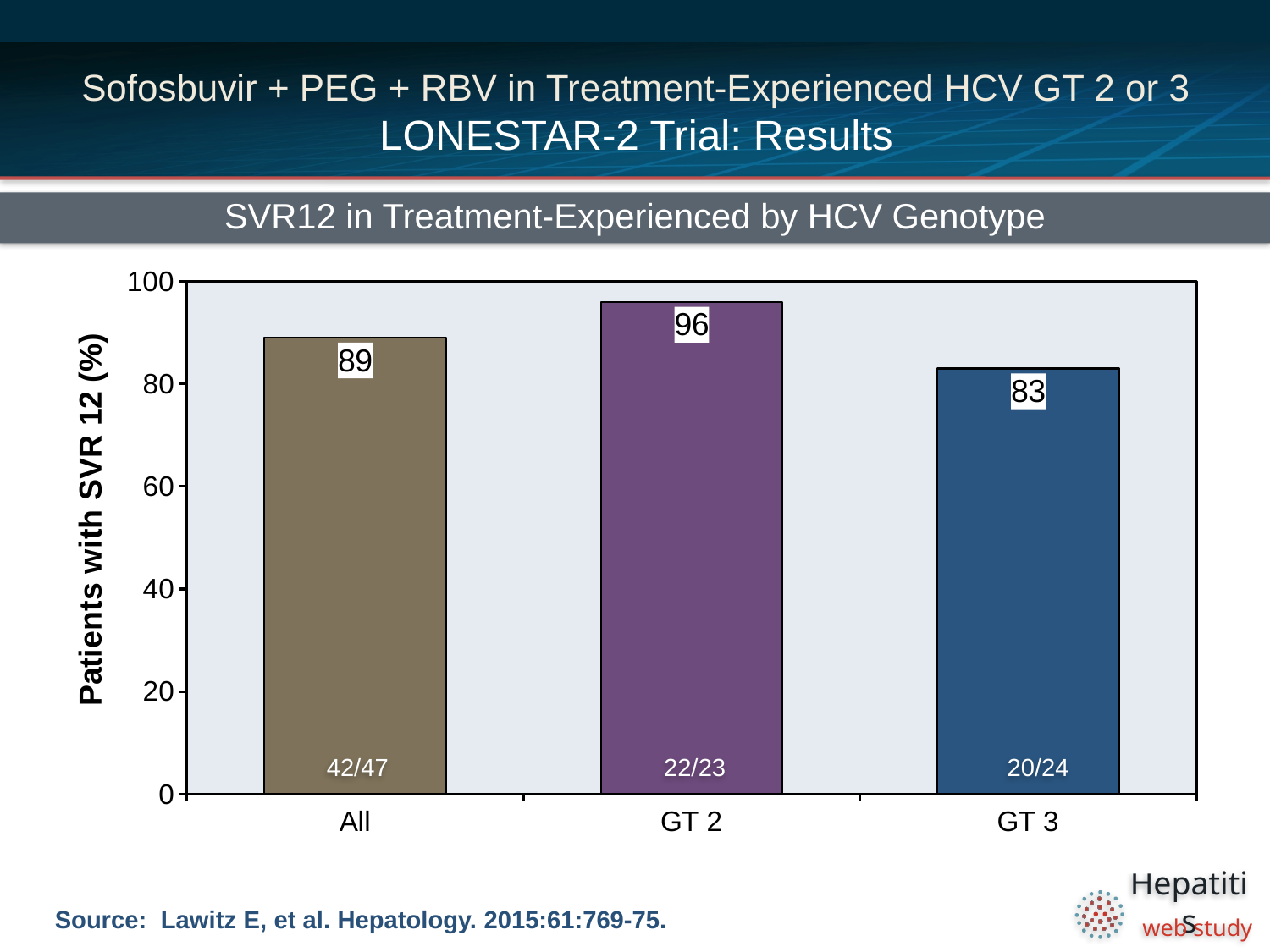
Which has a higher SVR12 rate, All or GT 3? All How many groups are shown on the x axis? 3 What is the SVR12 rate for the GT 2 group? 96 What is the difference in SVR12 rate between GT 2 and GT 3? 13 What kind of chart is shown on the slide? Bar chart Is the SVR12 rate for GT 3 greater or less than 80? greater What fraction of patients is shown inside the GT 3 bar? 20/24 Which group has the lowest SVR12 rate? GT 3 What is the SVR12 rate for the All group? 89 Which group has the highest SVR12 rate? GT 2 What is the SVR12 rate for the GT 3 group? 83 What is the title of the chart? SVR12 in Treatment-Experienced by HCV Genotype